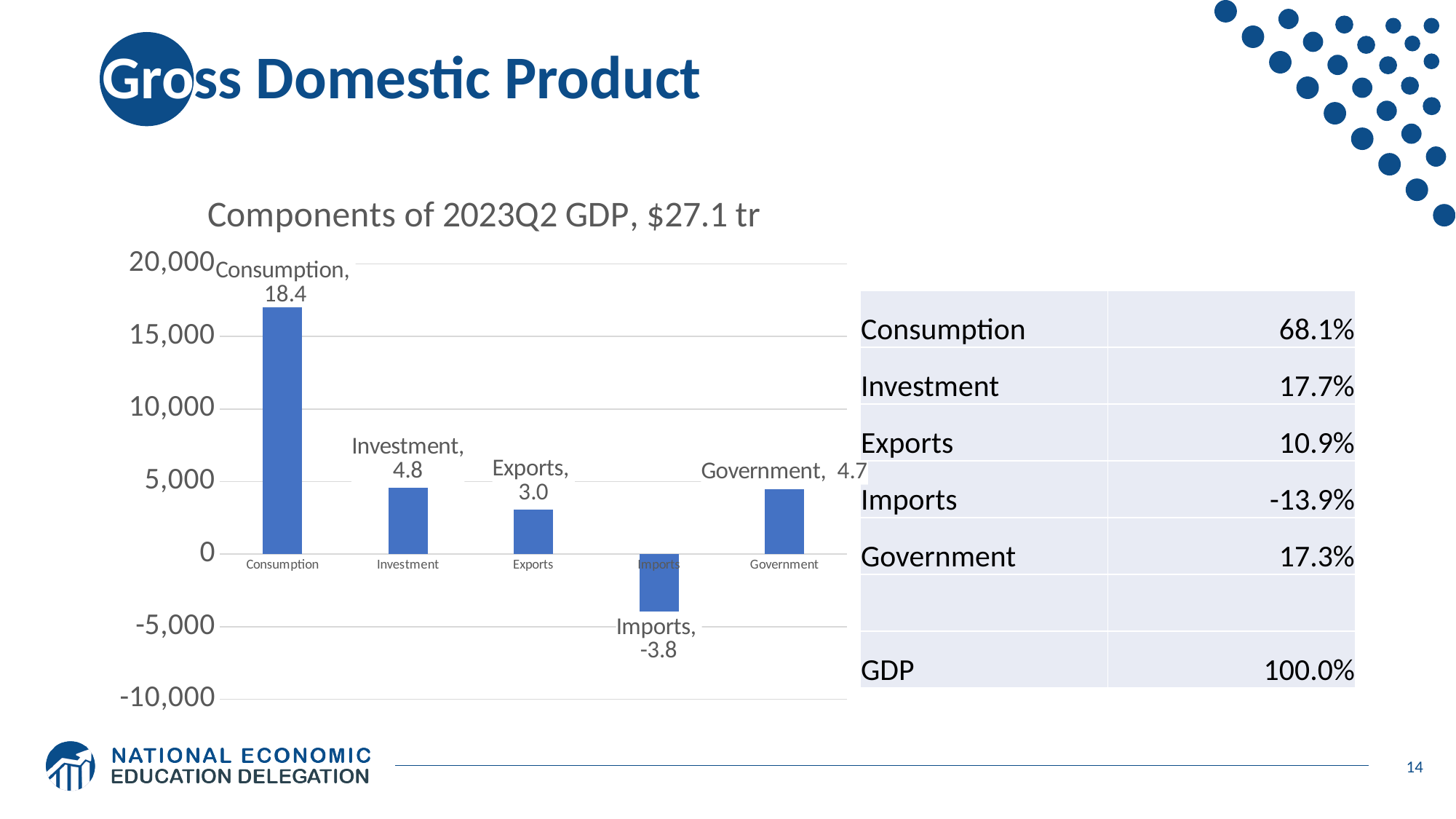
How many components are plotted in the chart? 5 What is the data label value for Exports in the chart? 3.0 Which component has the highest value in the chart? Consumption What is the data label value for Government in the chart? 4.7 What is the difference between the Consumption and Investment data labels in the chart? 13.6 What is the data label value for Investment in the chart? 4.8 Which is larger in the chart, Consumption or Exports? Consumption Is the value for Consumption greater or less than 15,000 on the axis? greater What is the data label value for Imports in the chart? -3.8 What is the data label value for Consumption in the chart? 18.4 What is the title of the chart? Components of 2023Q2 GDP, $27.1 tr Which component has the lowest value in the chart? Imports